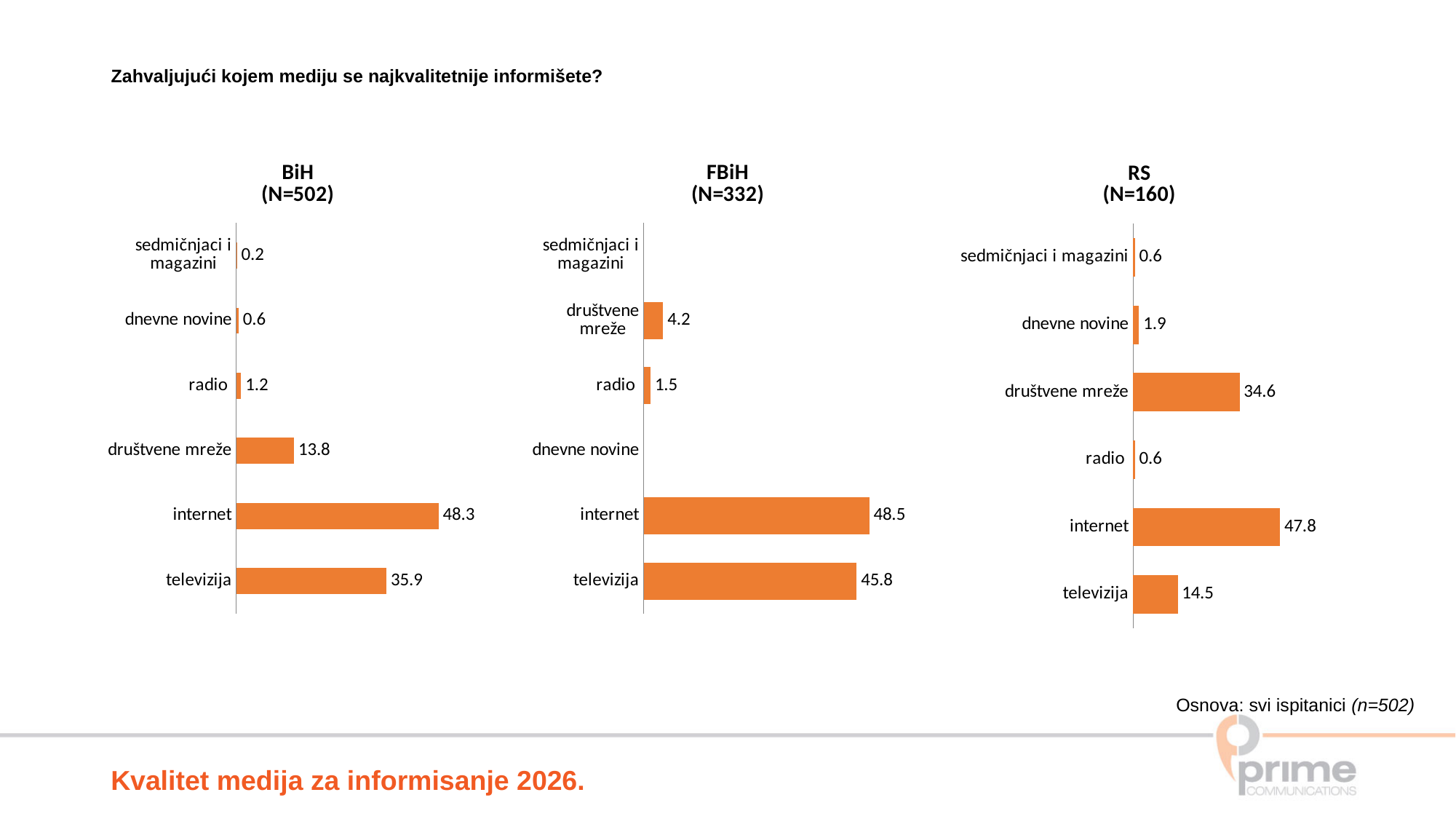
In the FBiH (N=332) chart, which is larger, the value for društvene mreže or the value for radio? društvene mreže In the BiH (N=502) chart, what is the difference between the values for internet and televizija? 12.4 In the RS (N=160) chart, what is the value for društvene mreže? 34.6 In the FBiH (N=332) chart, what is the value for televizija? 45.8 What type of chart is the FBiH (N=332) chart? bar chart In the RS (N=160) chart, what is the difference between the values for internet and televizija? 33.3 In the BiH (N=502) chart, what is the value for internet? 48.3 In the BiH (N=502) chart, what is the value for društvene mreže? 13.8 How many categories are shown in the RS (N=160) chart? 6 In the BiH (N=502) chart, which category has the lowest value? sedmičnjaci i magazini How many charts are shown on the slide? 3 In the RS (N=160) chart, which category has the highest value? internet